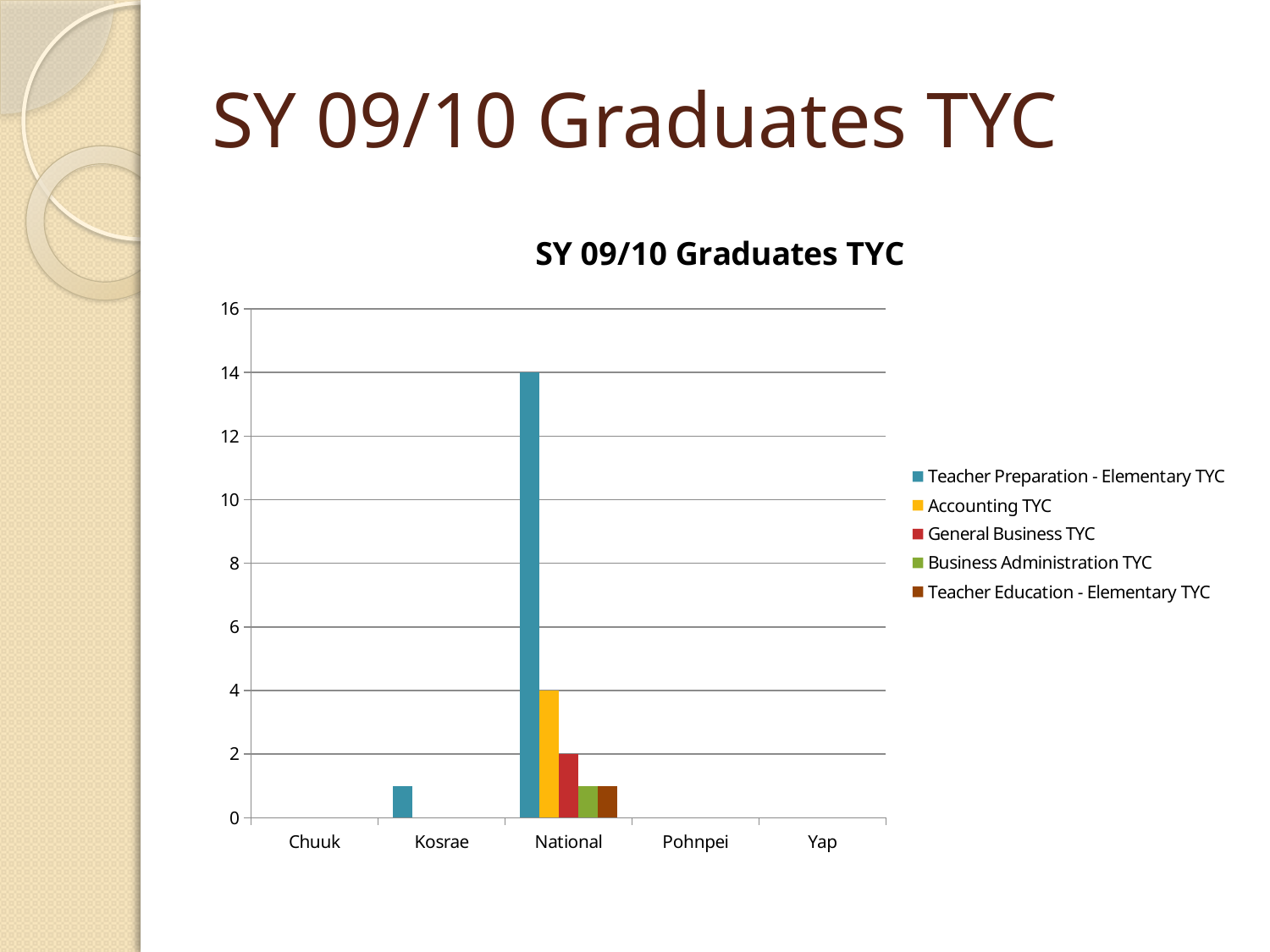
How many series does the legend list? 5 What is the difference between Teacher Preparation - Elementary TYC and Accounting TYC in the National category? 10 What is the value for Teacher Preparation - Elementary TYC in the National category? 14 Which category has the tallest bar in the chart? National Is the value for Teacher Preparation - Elementary TYC in Kosrae greater or less than 2? less What is the value for General Business TYC in the National category? 2 Which series has the highest value in the National category? Teacher Preparation - Elementary TYC What is the value for Accounting TYC in the National category? 4 What type of chart is shown on the slide? bar chart How many categories are shown on the x axis? 5 Which is larger in the National category: Accounting TYC or General Business TYC? Accounting TYC What is the title of the chart? SY 09/10 Graduates TYC